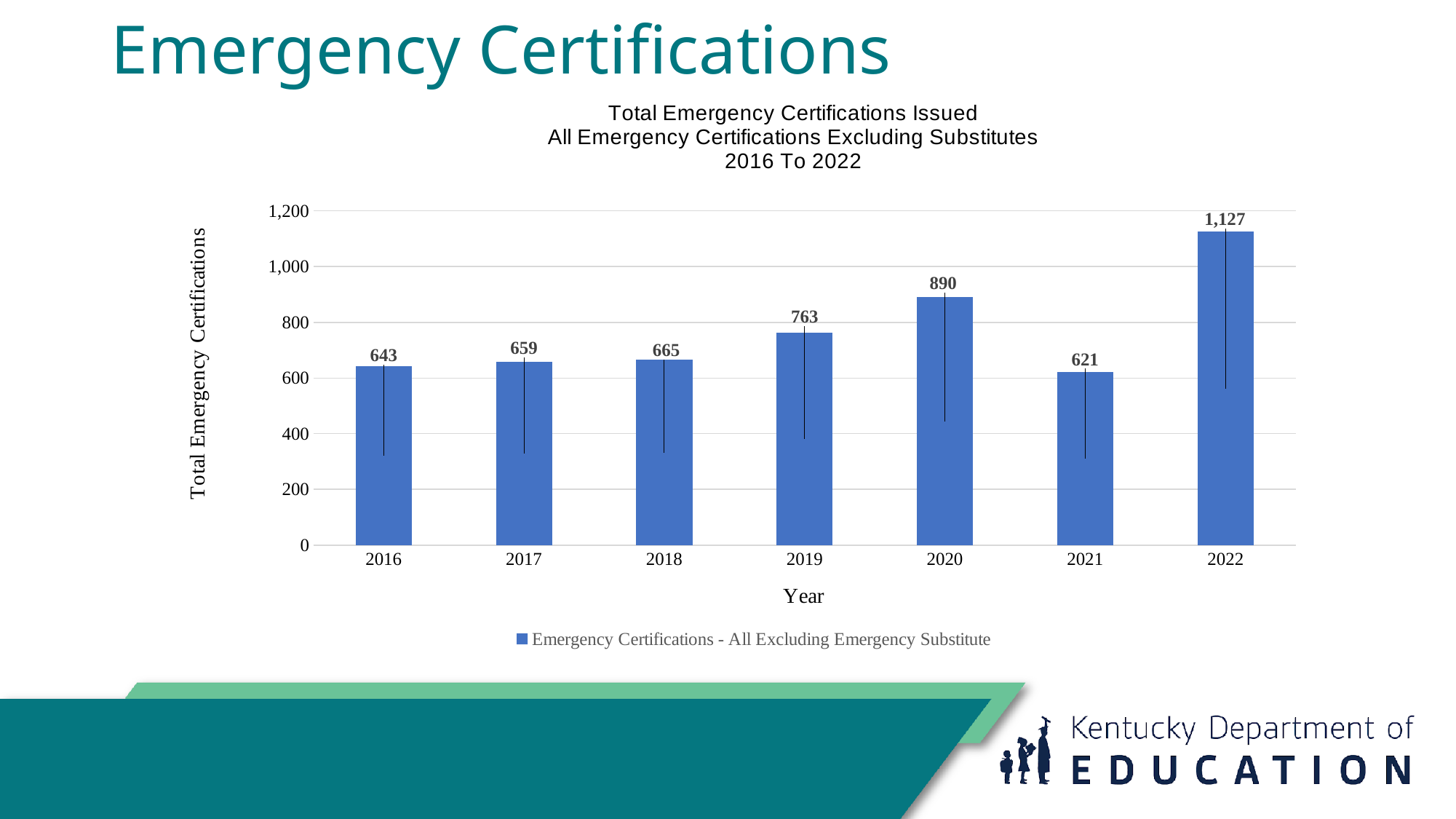
Which year has the highest value? 2022 Which is larger, the value for 2019 or the value for 2018? 2019 Which year has the lowest value? 2021 What is the value for 2016? 643 What kind of chart is shown? bar chart What is the label of the y axis? Total Emergency Certifications Is the value for 2020 greater or less than 800? greater How many series does the legend list? 1 What is the value for 2022? 1,127 What is the value for 2020? 890 How many years are shown on the x axis? 7 What is the difference between the values for 2022 and 2021? 506